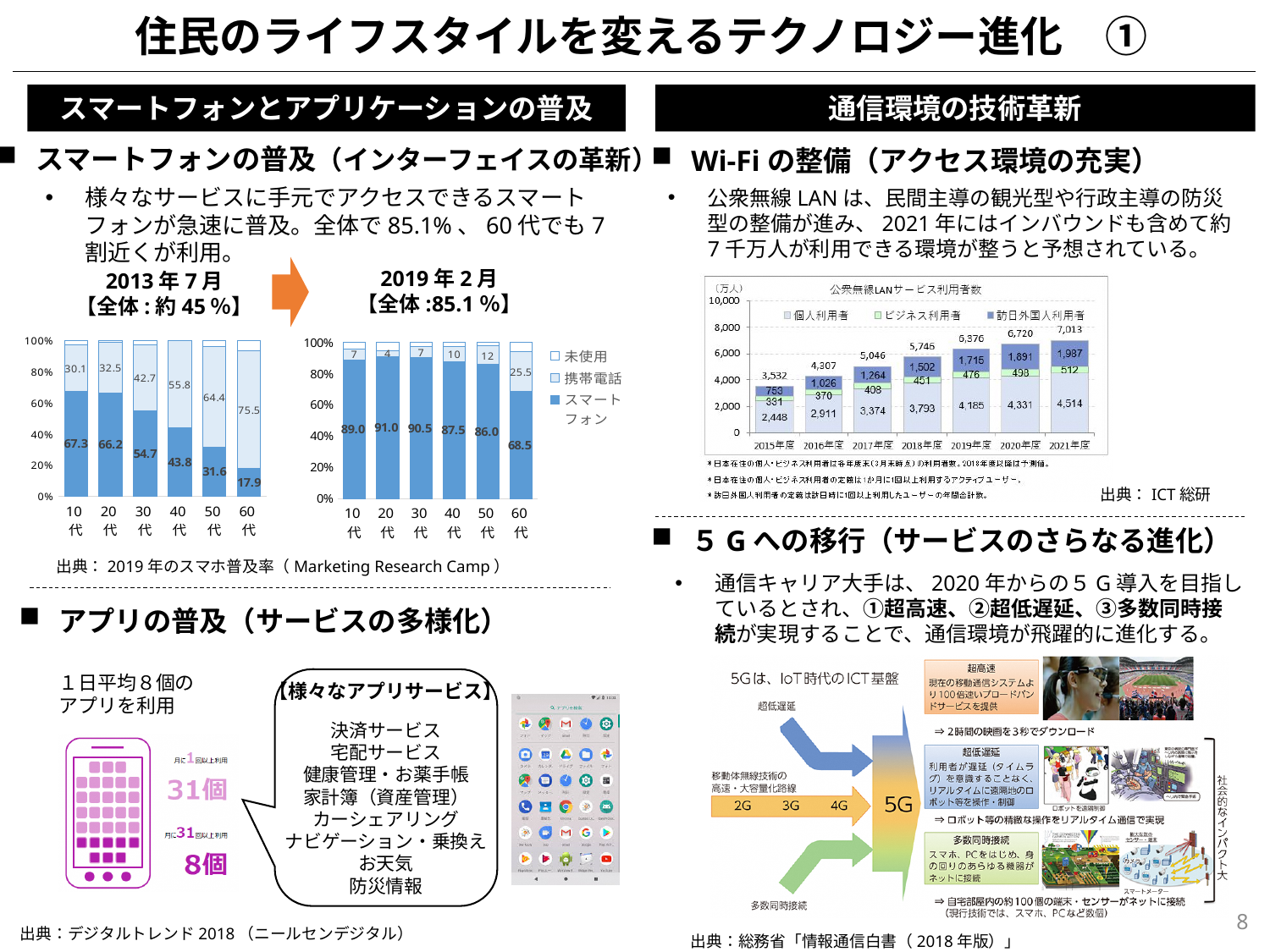
In the 公衆無線LANサービス利用者数 chart, how many fiscal years are shown on the x axis? 7 In the 公衆無線LANサービス利用者数 chart, do the totals rise or fall from 2015年度 to 2021年度? Rise In the 2013年7月 chart, what is the スマートフォン value for 60代? 17.9 In the 2013年7月 chart, what is the 携帯電話 value for 50代? 64.4 In the 2019年2月 chart, which age group has the lowest スマートフォン value? 60代 In the 公衆無線LANサービス利用者数 chart, what is the 訪日外国人利用者 value for 2017年度? 1,264 In the 2013年7月 chart, which age group has the highest スマートフォン value? 10代 In the 2019年2月 chart, what is the スマートフォン value for 20代? 91.0 What kind of chart is the 2013年7月 chart? Stacked bar chart How many series does the legend of the 2019年2月 chart list? 3 In the 2019年2月 chart, what is the difference between the スマートフォン values for 20代 and 60代? 22.5 In the 公衆無線LANサービス利用者数 chart, what is the total for 2021年度? 7,013